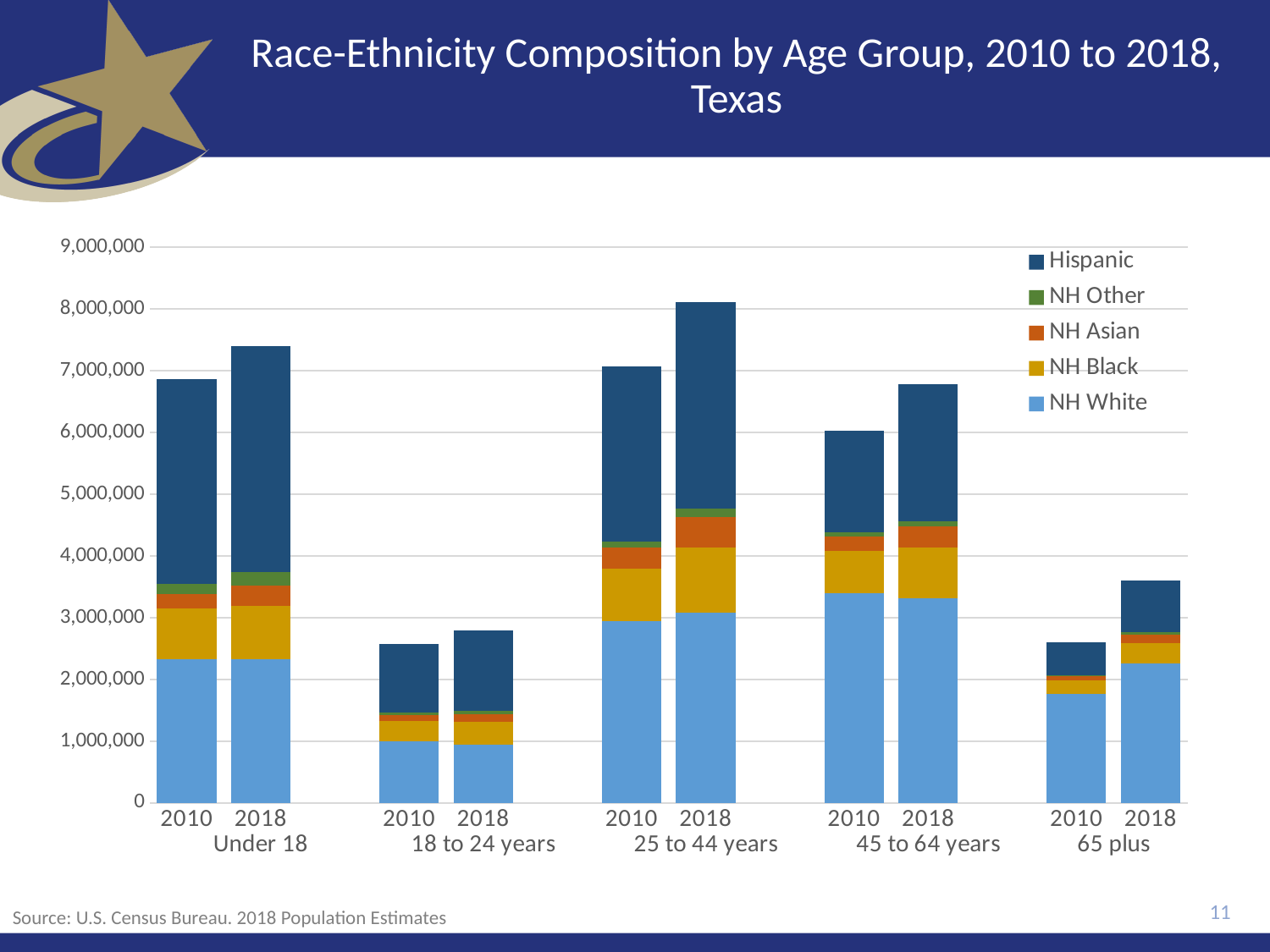
For the 45 to 64 years group, which year has the larger total, 2010 or 2018? 2018 Which bar has the highest total population? 25 to 44 years, 2018 Which is larger in 2018: the total for 65 plus or the total for 18 to 24 years? 65 plus Is the total for 18 to 24 years in 2018 greater or less than 3,000,000? less Is the total for 25 to 44 years in 2018 greater or less than 8,000,000? greater Which series is shown at the bottom of each stacked bar? NH White How many series does the legend list? 5 How many bars are plotted in the chart? 10 Is the total for Under 18 in 2018 greater or less than 7,000,000? greater How many age groups are shown on the x axis? 5 What kind of chart is shown on the slide? Stacked bar chart